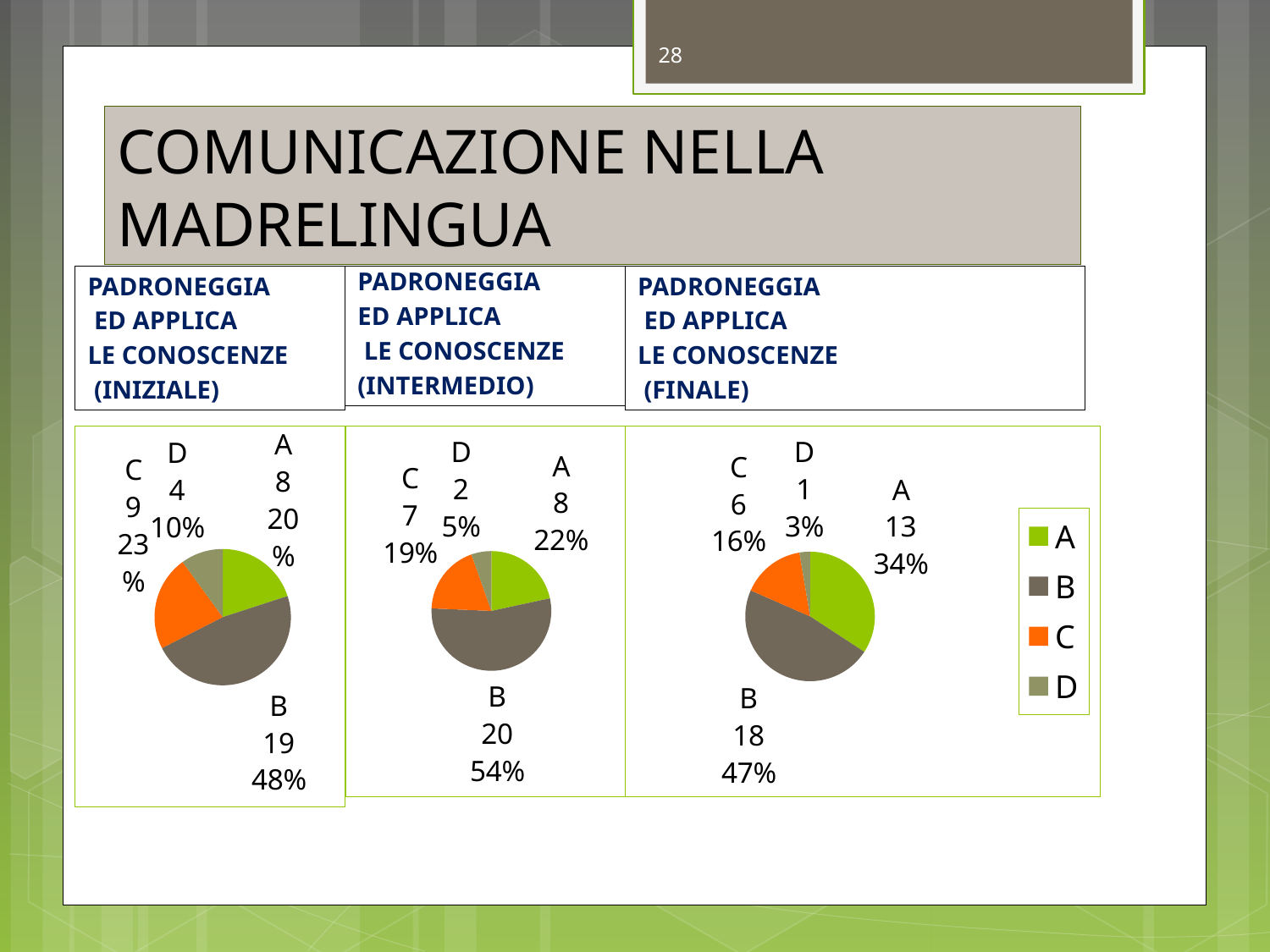
In the INIZIALE pie chart, what percentage share does category C have? 23% In the INTERMEDIO pie chart, what is the value for category D? 2 What type of chart is used for the INIZIALE, INTERMEDIO and FINALE data? Pie chart In the FINALE pie chart, what is the difference between the values for B and A? 5 In the INIZIALE pie chart, which category has the smallest slice? D In the INIZIALE pie chart, what is the value for category B? 19 In the FINALE pie chart, what percentage share does category D have? 3% In the INTERMEDIO pie chart, which is larger, the value for A or the value for C? A In the FINALE pie chart, what is the value for category A? 13 In the INTERMEDIO pie chart, what percentage share does category B have? 54% How many categories does the legend on the slide list? 4 In the FINALE pie chart, which category has the largest slice? B